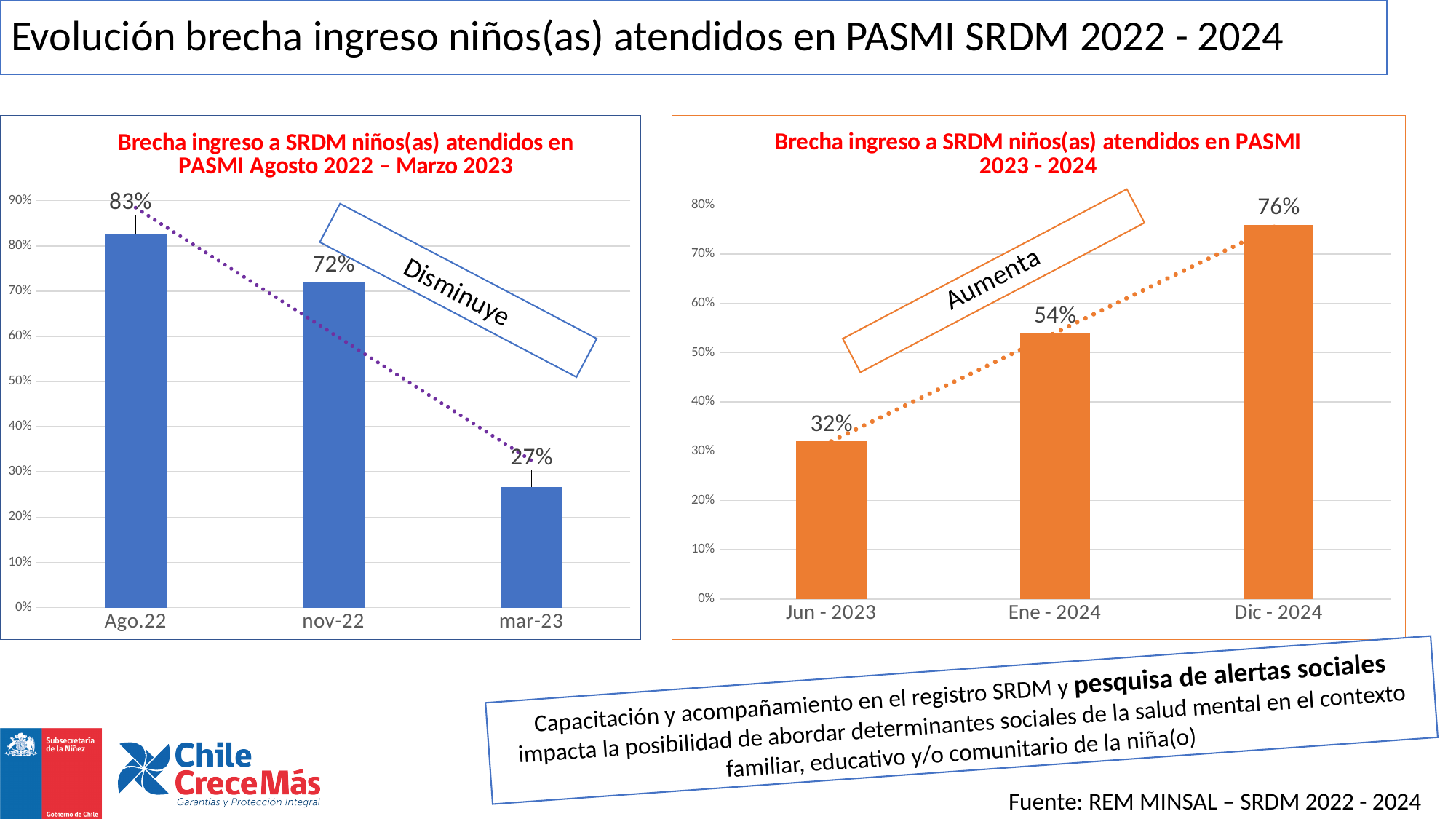
In the left chart (Agosto 2022 – Marzo 2023), what is the difference between the values for Ago.22 and nov-22? 11% In the left chart (Agosto 2022 – Marzo 2023), what is the value for Ago.22? 83% In the left chart (Agosto 2022 – Marzo 2023), do the values rise or fall from Ago.22 to mar-23? fall In the right chart (2023 - 2024), how many categories are shown on the x axis? 3 In the right chart (2023 - 2024), which category has the highest value? Dic - 2024 In the right chart (2023 - 2024), what is the value for Ene - 2024? 54% In the left chart (Agosto 2022 – Marzo 2023), what is the value for mar-23? 27% In the right chart (2023 - 2024), which is larger, the value for Jun - 2023 or Ene - 2024? Ene - 2024 What kind of chart is the right chart (2023 - 2024)? bar chart In the left chart (Agosto 2022 – Marzo 2023), which category has the lowest value? mar-23 In the right chart (2023 - 2024), what is the value for Dic - 2024? 76% In the right chart (2023 - 2024), what is the difference between the values for Dic - 2024 and Jun - 2023? 44%